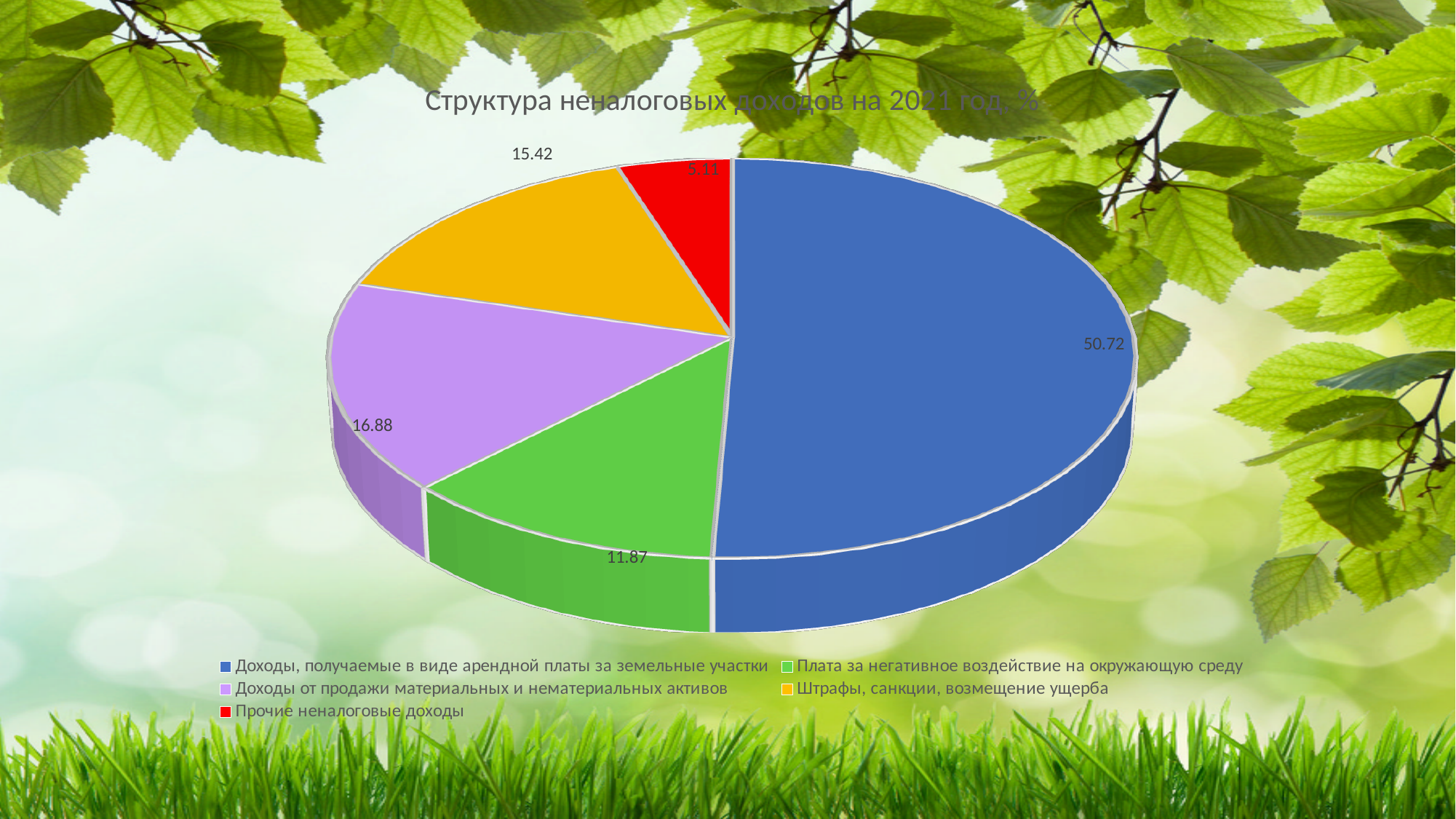
What is the difference between the values for "Доходы от продажи материальных и нематериальных активов" and "Штрафы, санкции, возмещение ущерба"? 1.46 What is the value for "Плата за негативное воздействие на окружающую среду"? 11.87 What is the value for "Доходы, получаемые в виде арендной платы за земельные участки"? 50.72 What is the value for "Штрафы, санкции, возмещение ущерба"? 15.42 What is the value for "Доходы от продажи материальных и нематериальных активов"? 16.88 How many slices does the pie chart have? 5 Which category has the smallest share of the pie? Прочие неналоговые доходы Which is larger: the value for "Плата за негативное воздействие на окружающую среду" or the value for "Штрафы, санкции, возмещение ущерба"? Штрафы, санкции, возмещение ущерба What is the title of the chart? Структура неналоговых доходов на 2021 год, % Which category has the largest share of the pie? Доходы, получаемые в виде арендной платы за земельные участки What kind of chart is shown on the slide? Pie chart What is the value for "Прочие неналоговые доходы"? 5.11